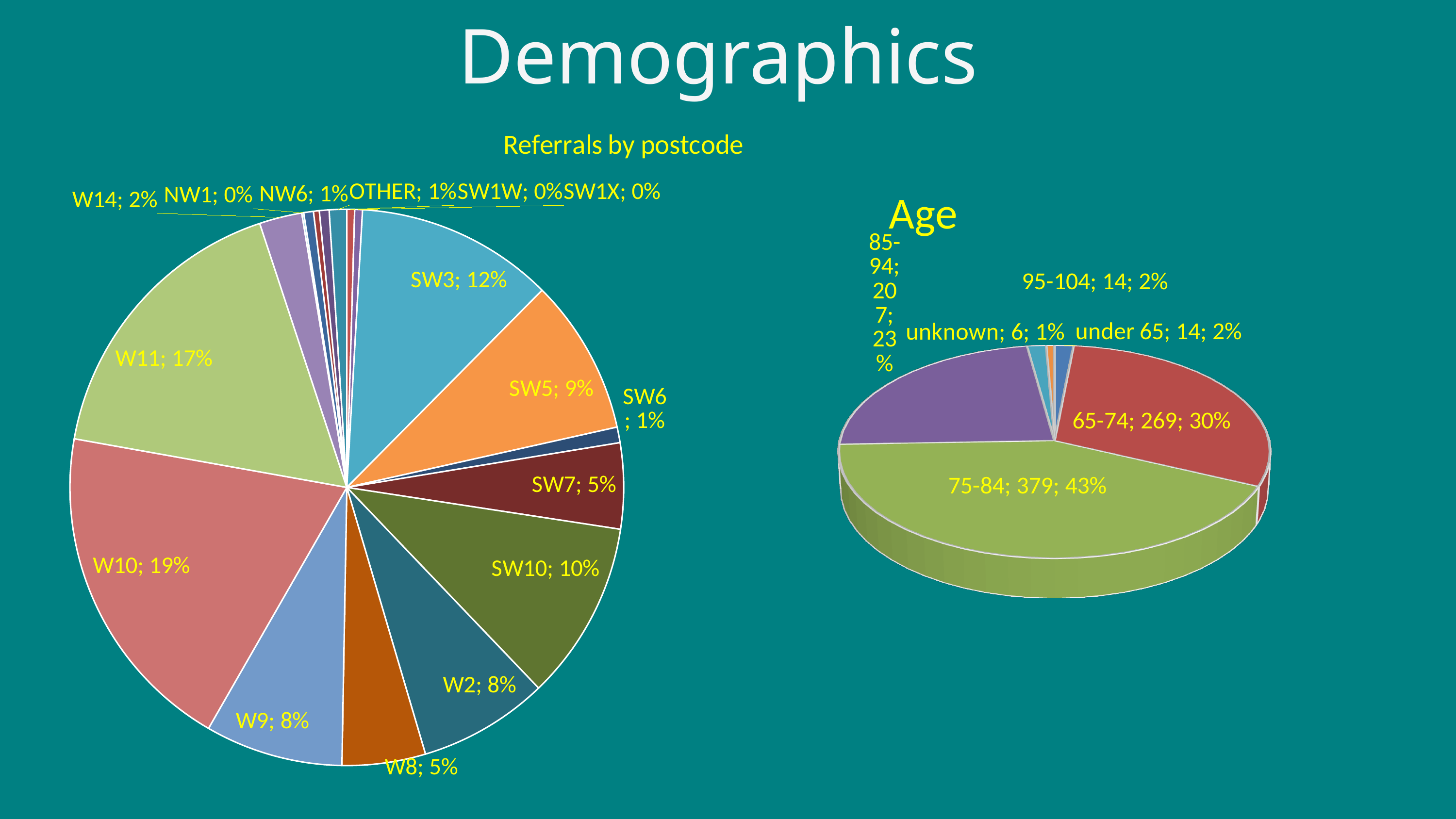
In the Age chart, which age group has the smallest count? unknown In the Referrals by postcode chart, which postcode has the largest share of referrals? W10 In the Age chart, how many categories are shown? 6 What type of chart is the Age chart? Pie chart In the Referrals by postcode chart, what share of referrals is from W10? 19% In the Referrals by postcode chart, what is the difference in percentage points between W10 and W11? 2 In the Age chart, how many people are in the 75-84 age group? 379 In the Referrals by postcode chart, what share of referrals is from SW3? 12% In the Age chart, what is the difference between the counts for 75-84 and 65-74? 110 In the Referrals by postcode chart, which is larger, the share for W11 or the share for SW5? W11 In the Age chart, what percentage of the total is the 65-74 age group? 30%